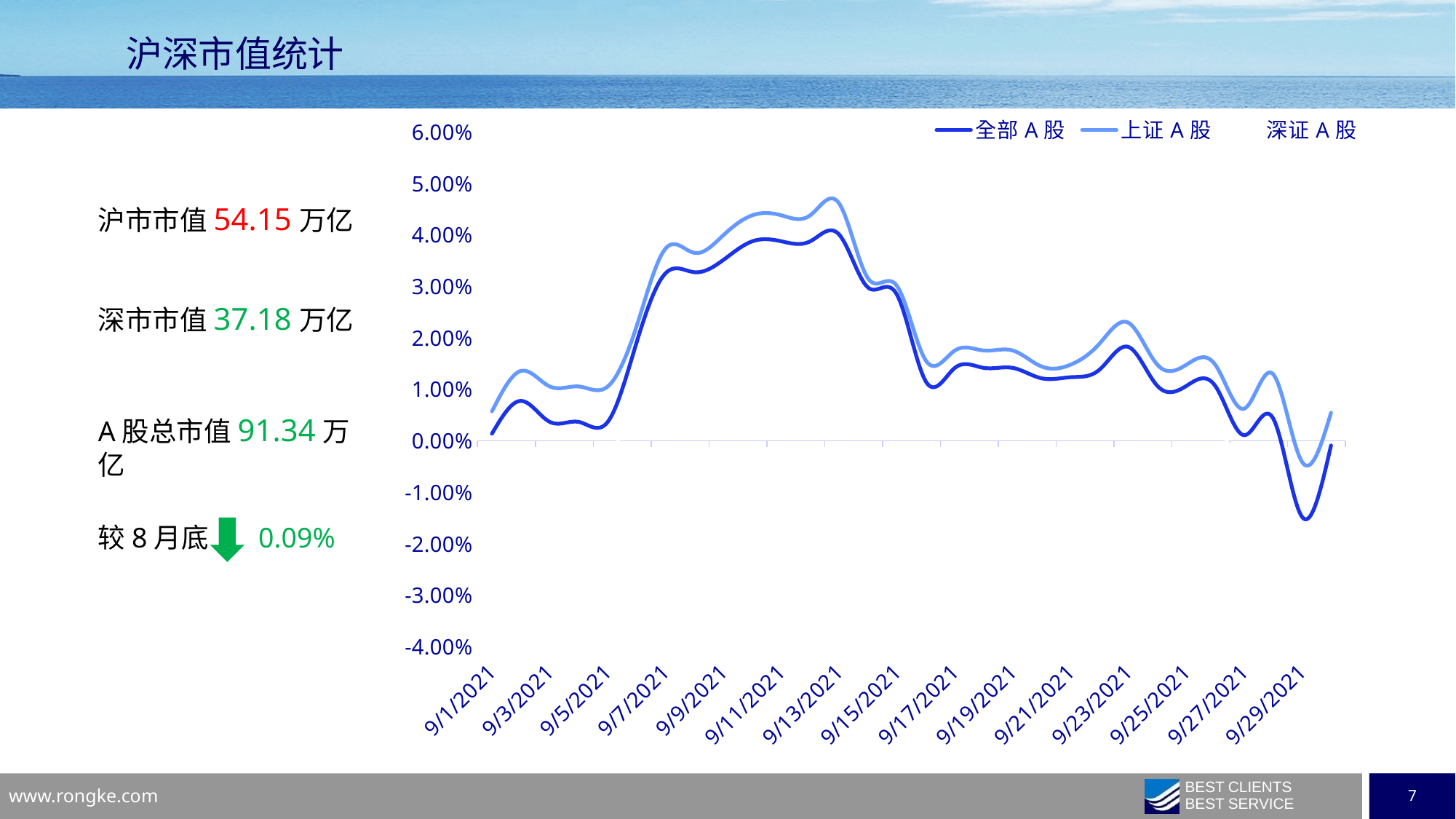
What is the title of the slide containing the chart? 沪深市值统计 Is the value for 上证A股 on 9/1/2021 greater or less than 1.00%? less Is the value for 全部A股 on 9/29/2021 greater or less than -1.00%? less What are the three series named in the chart legend? 全部A股, 上证A股, 深证A股 How many series does the chart legend list? 3 How many date labels are shown on the x axis of the chart? 15 Is the value for 上证A股 on 9/13/2021 greater or less than 4.00%? greater Do the values for 全部A股 rise or fall between 9/5/2021 and 9/7/2021? rise On 9/13/2021, which series has the higher value, 上证A股 or 全部A股? 上证A股 What kind of chart is shown on the slide? line chart